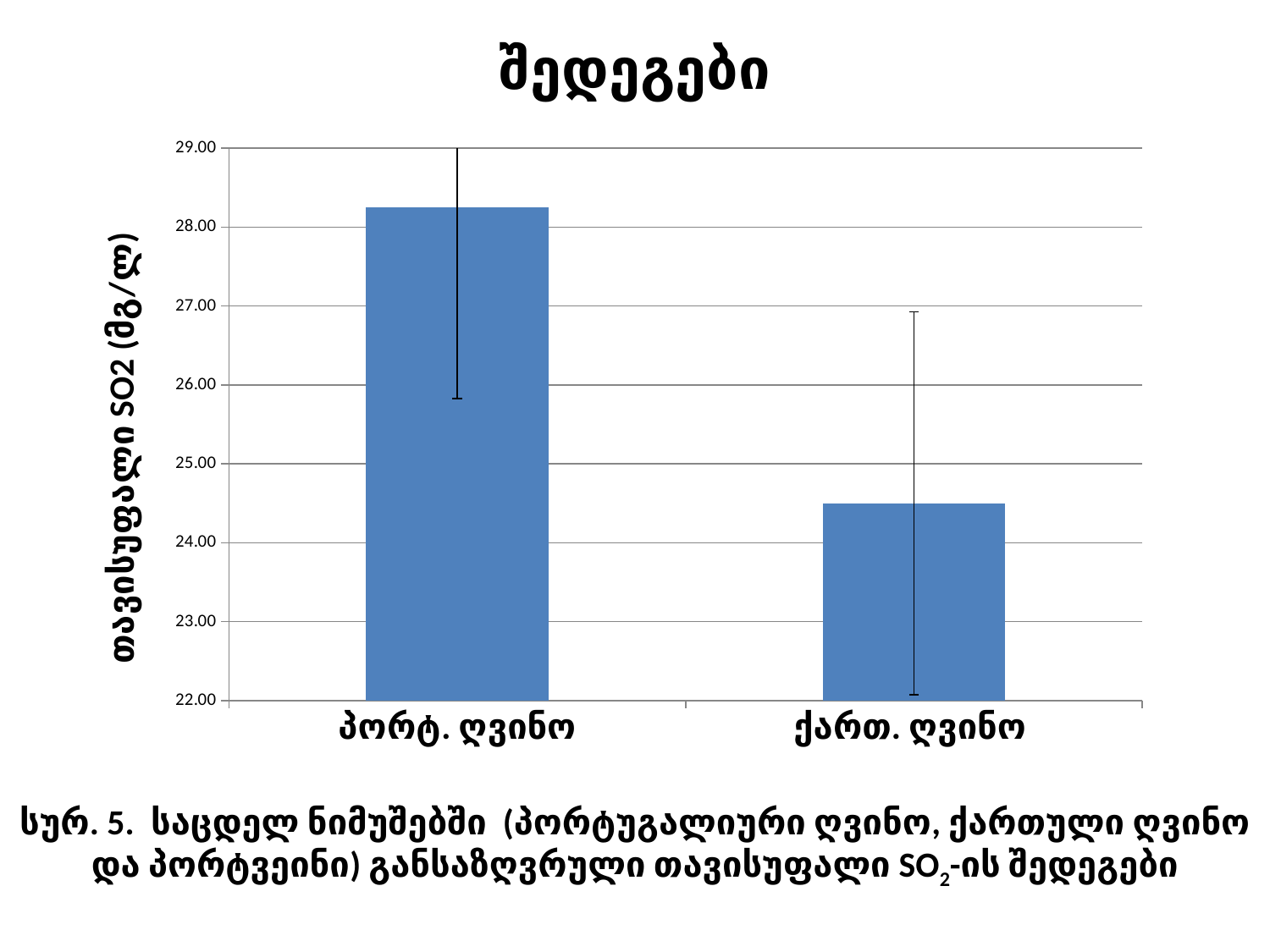
Is the value for ქართ. ღვინო greater or less than 25.00? less What is the label of the vertical axis? თავისუფალი SO2 (მგ/ლ) Which is larger, the value for პორტ. ღვინო or the value for ქართ. ღვინო? პორტ. ღვინო Is the value for პორტ. ღვინო greater or less than 28.00? greater Which category has the highest value in the chart? პორტ. ღვინო Do the bar values rise or fall from left to right along the x axis? fall Which category has the lowest value in the chart? ქართ. ღვინო Is the value for ქართ. ღვინო greater or less than 24.00? greater What is the title of the chart? შედეგები How many categories (bars) are plotted in the chart? 2 What kind of chart is shown on the slide? bar chart